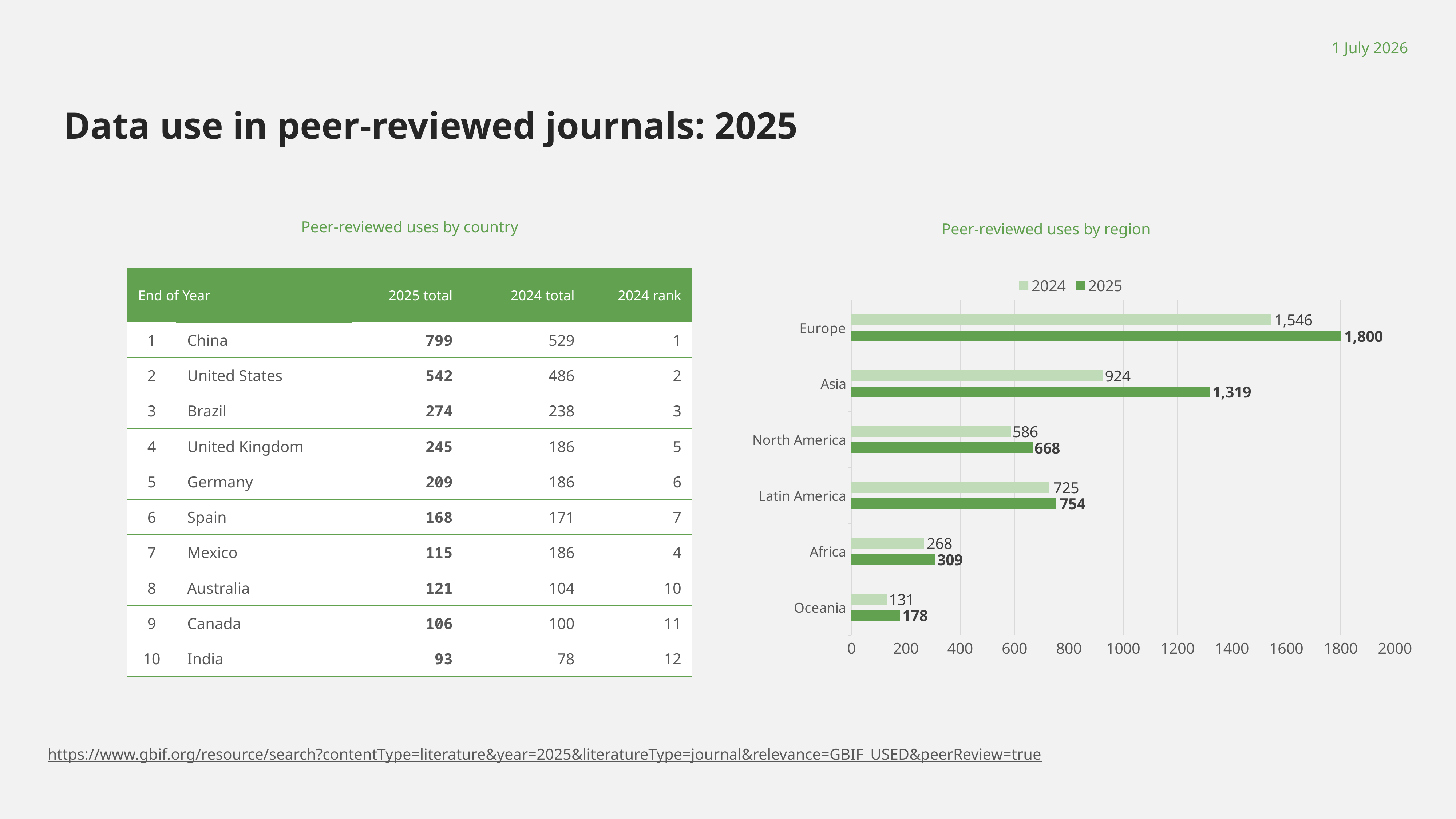
In the 'Peer-reviewed uses by region' chart, which region has the lowest 2024 value? Oceania In the 'Peer-reviewed uses by region' chart, what is the 2025 value for Europe? 1,800 How many regions are shown in the 'Peer-reviewed uses by region' chart? 6 In the 'Peer-reviewed uses by region' chart, what is the difference between the 2025 and 2024 values for Asia? 395 What type of chart is 'Peer-reviewed uses by region'? bar chart In the 'Peer-reviewed uses by region' chart, is the 2024 value for Africa greater or less than 200? greater In the 'Peer-reviewed uses by region' chart, which region has the highest 2025 value? Europe In the 'Peer-reviewed uses by region' chart, what is the 2024 value for Asia? 924 In the 'Peer-reviewed uses by region' chart, what is the difference between the 2025 and 2024 values for North America? 82 In the 'Peer-reviewed uses by region' chart, which is larger: the 2025 value for Latin America or the 2025 value for North America? Latin America In the 'Peer-reviewed uses by region' chart, what is the 2025 value for Oceania? 178 How many series does the legend of the 'Peer-reviewed uses by region' chart list? 2